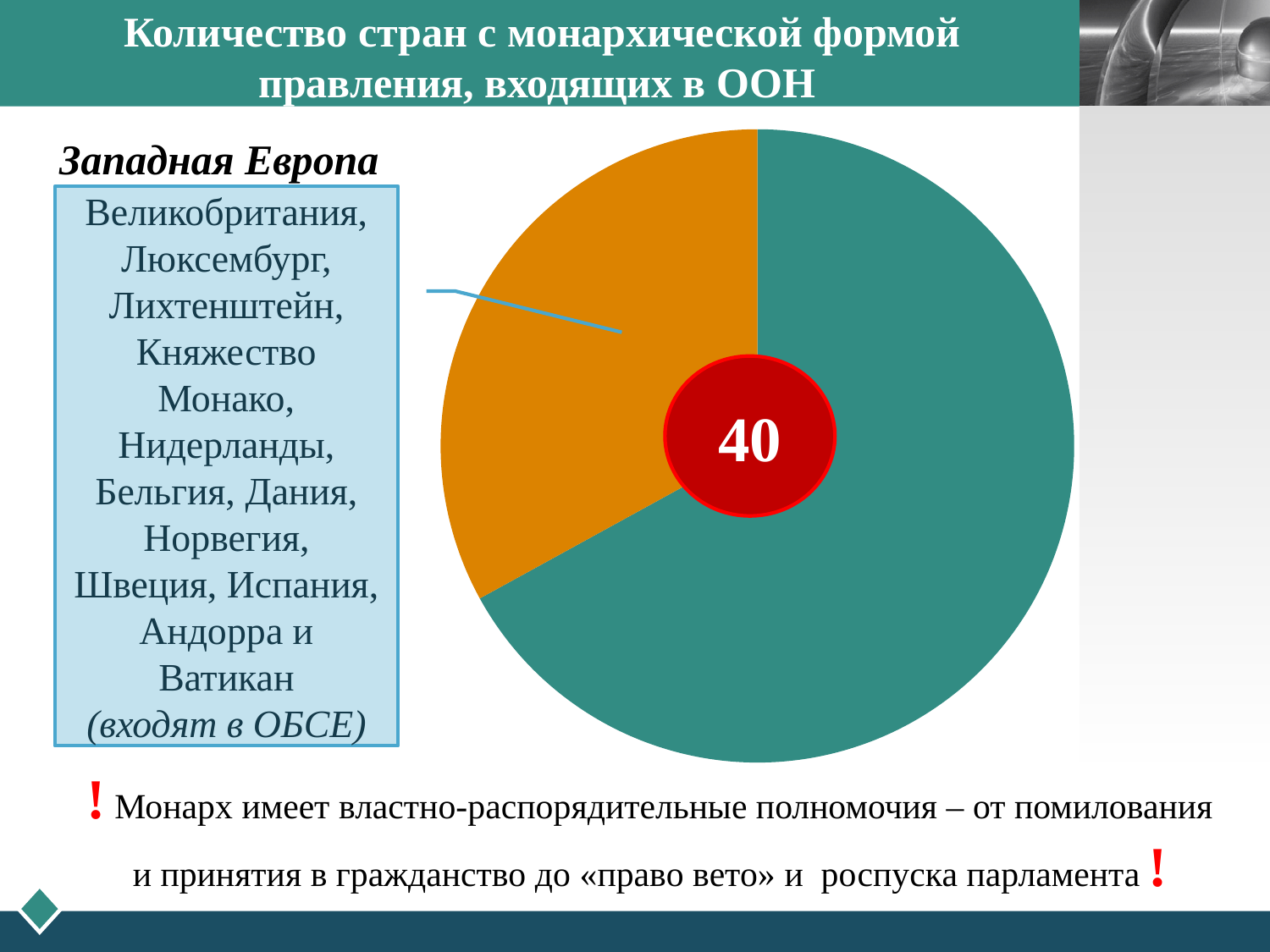
Does the orange slice labelled Западная Европа take up more or less than half of the pie? less Which slice of the pie chart is larger, the teal one or the orange one? the teal one What colour is the slice that the callout 'Западная Европа' points to? orange How many slices does the pie chart have? 2 Which slice of the pie chart is the smallest? the orange slice (Западная Европа) What is the title of the chart on the slide? Количество стран с монархической формой правления, входящих в ООН What number is printed in the red circle at the centre of the pie chart? 40 What kind of chart is shown on the slide? pie chart